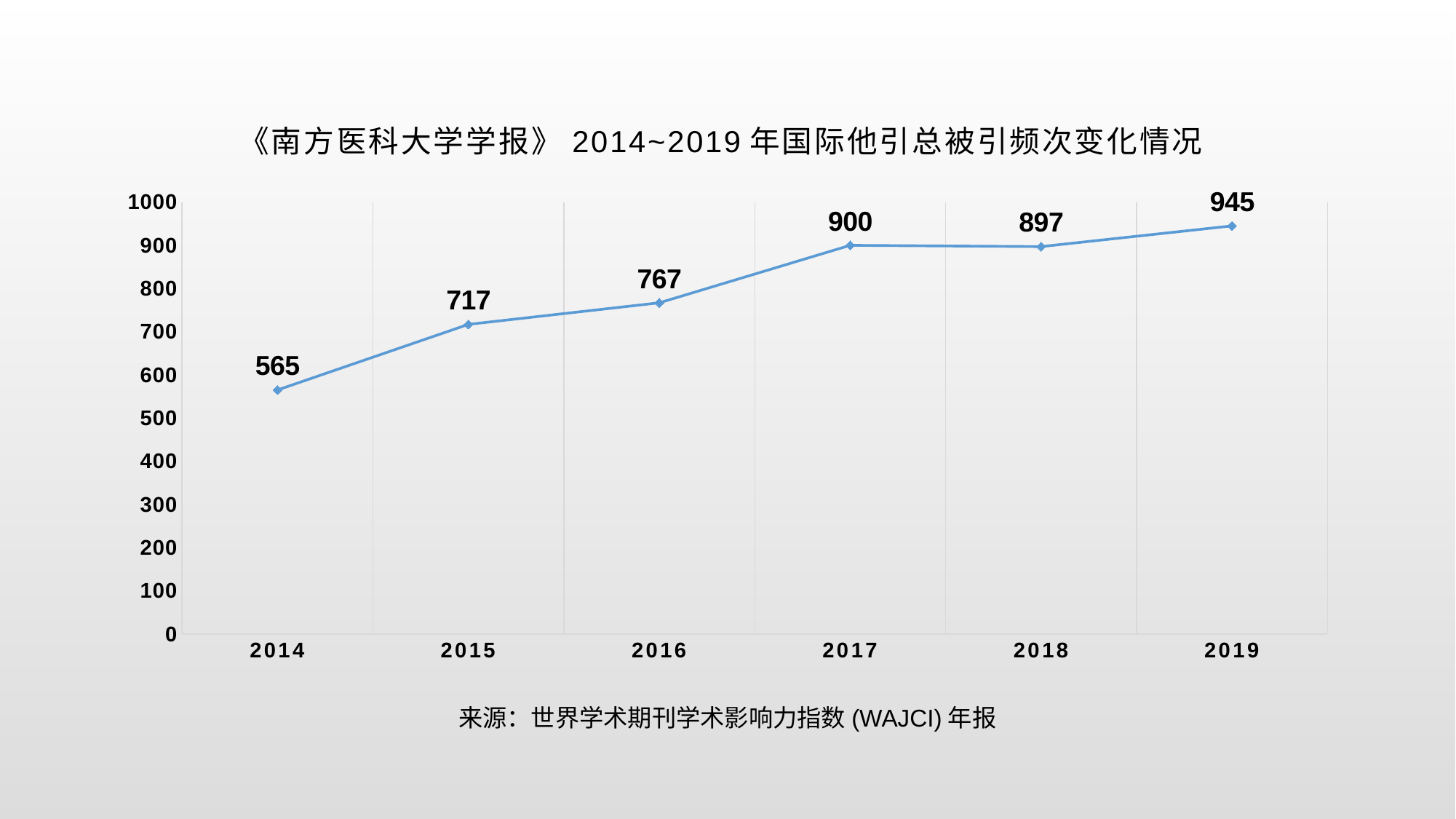
What is the value for 2017? 900 Which is larger, the value for 2017 or the value for 2018? 2017 What is the difference between the values for 2019 and 2014? 380 What is the value for 2014? 565 What is the difference between the values for 2017 and 2016? 133 Do the values generally rise or fall from 2014 to 2019? rise What kind of chart is shown on the slide? line chart Is the value for 2015 greater or less than 700? greater Which year has the highest value? 2019 How many years are plotted on the chart? 6 Which year has the lowest value? 2014 What is the value for 2019? 945